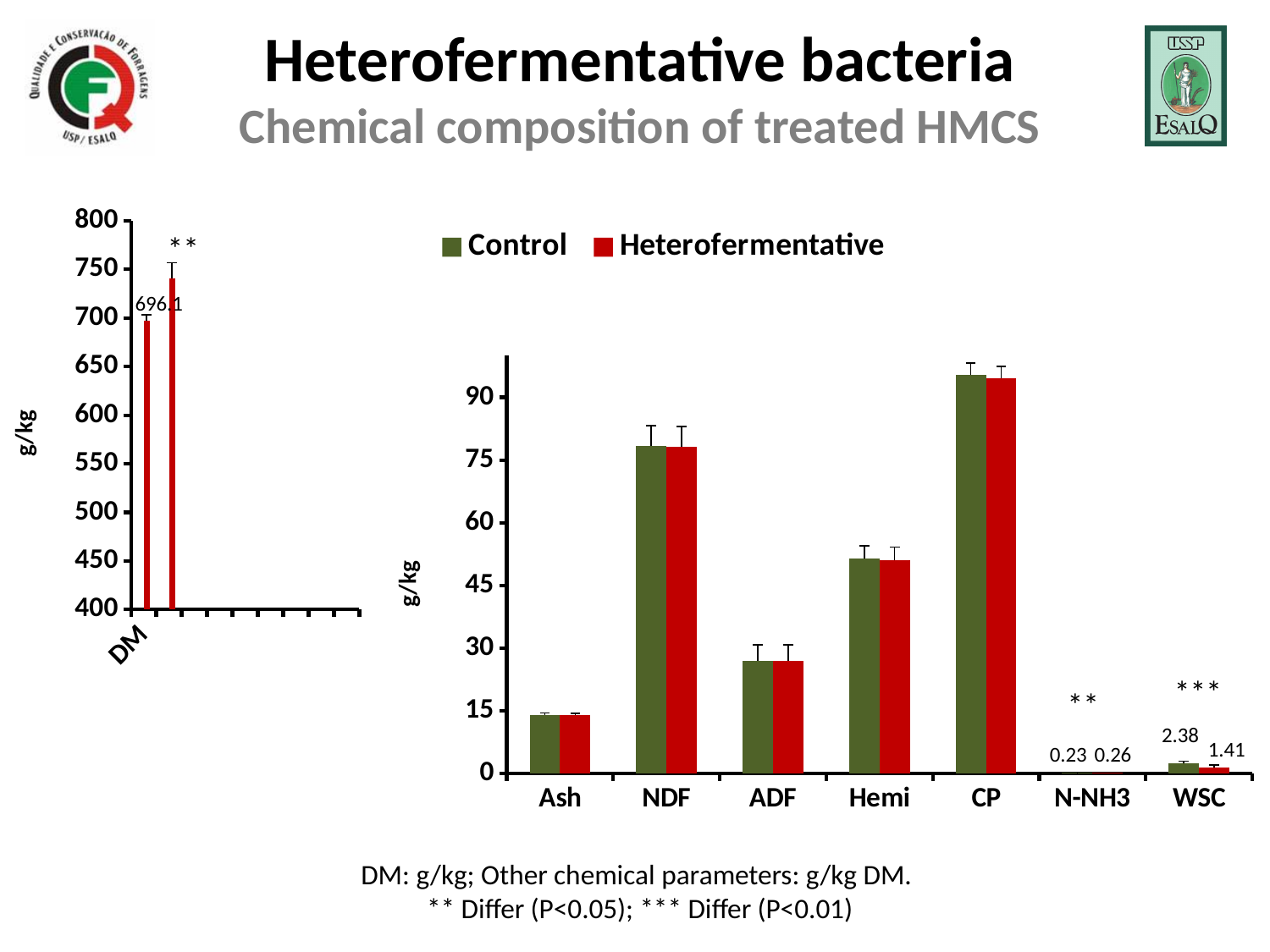
In the right chart, what is the Heterofermentative value for WSC? 1.41 In the left chart, what category is shown on the x axis? DM In the right chart, what is the Control value for WSC? 2.38 In the right chart, which category has the highest values? CP In the right chart, what is the Control value for N-NH3? 0.23 What kind of chart is the larger chart on the right of the slide? bar chart In the right chart, is the Control value for ADF greater or less than 30? less In the right chart, how many categories are shown on the x axis? 7 In the right chart, what is the Heterofermentative value for N-NH3? 0.26 In the right chart, what is the difference between the Control and Heterofermentative values for WSC? 0.97 In the right chart, which series has the larger value for WSC, Control or Heterofermentative? Control In the right chart, how many series does the legend list? 2